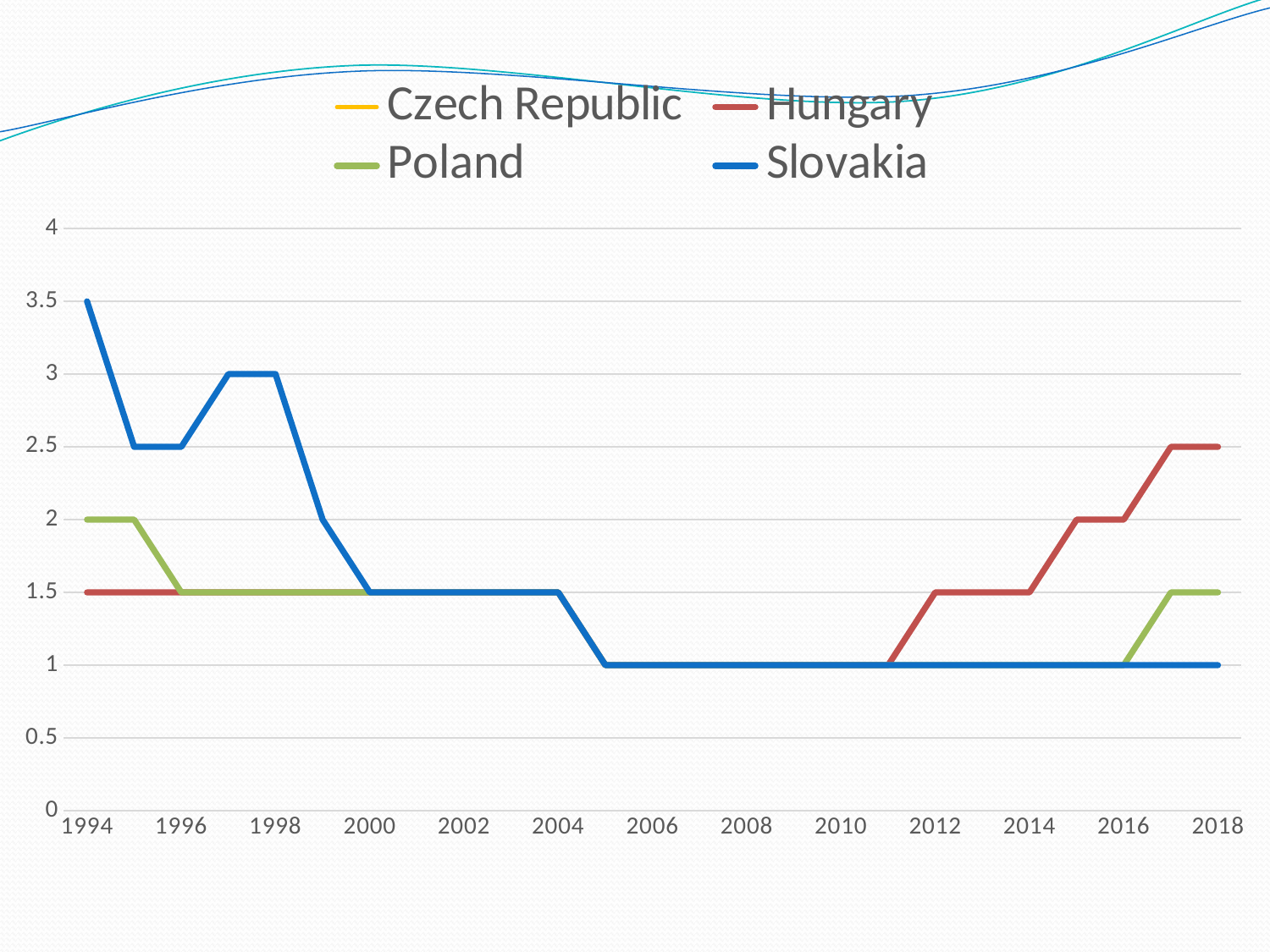
Does the value for Slovakia rise or fall from 1994 to 2018? fall What type of chart is shown on the slide? line chart What is the difference between Slovakia's value in 1994 and its value in 2018? 2.5 What is the value for Slovakia in 1994? 3.5 What is the value for Hungary in 2018? 2.5 In 2018, which is larger: the value for Hungary or the value for Poland? Hungary How many series does the legend list? 4 What is the value for Poland in 1994? 2 What colour is the Slovakia line in the legend? blue Which series has the highest value in 2018? Hungary What is the value for Slovakia in 1998? 3